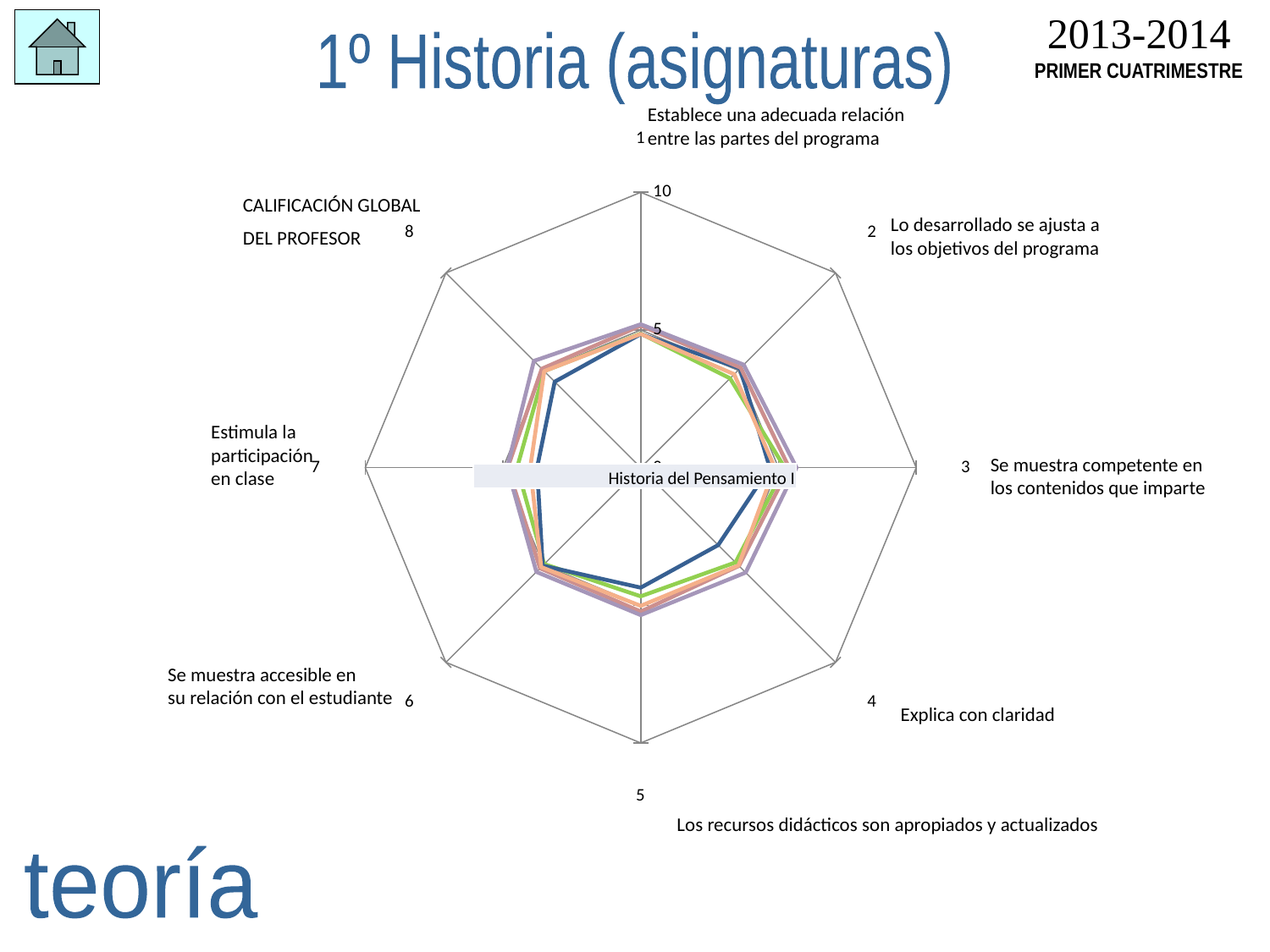
Which category is labelled with the number 8 on the radar chart? CALIFICACIÓN GLOBAL DEL PROFESOR What kind of chart is shown on the slide? radar chart What is the maximum value shown on the radar chart's axis scale? 10 Is the value for 'Explica con claridad' greater or less than 10? less Is the value for 'Se muestra competente en los contenidos que imparte' greater or less than 10? less Is the value for 'Estimula la participación en clase' greater or less than 0? greater What is the title of the slide containing the radar chart? 1º Historia (asignaturas) How many categories (axes) does the radar chart have? 8